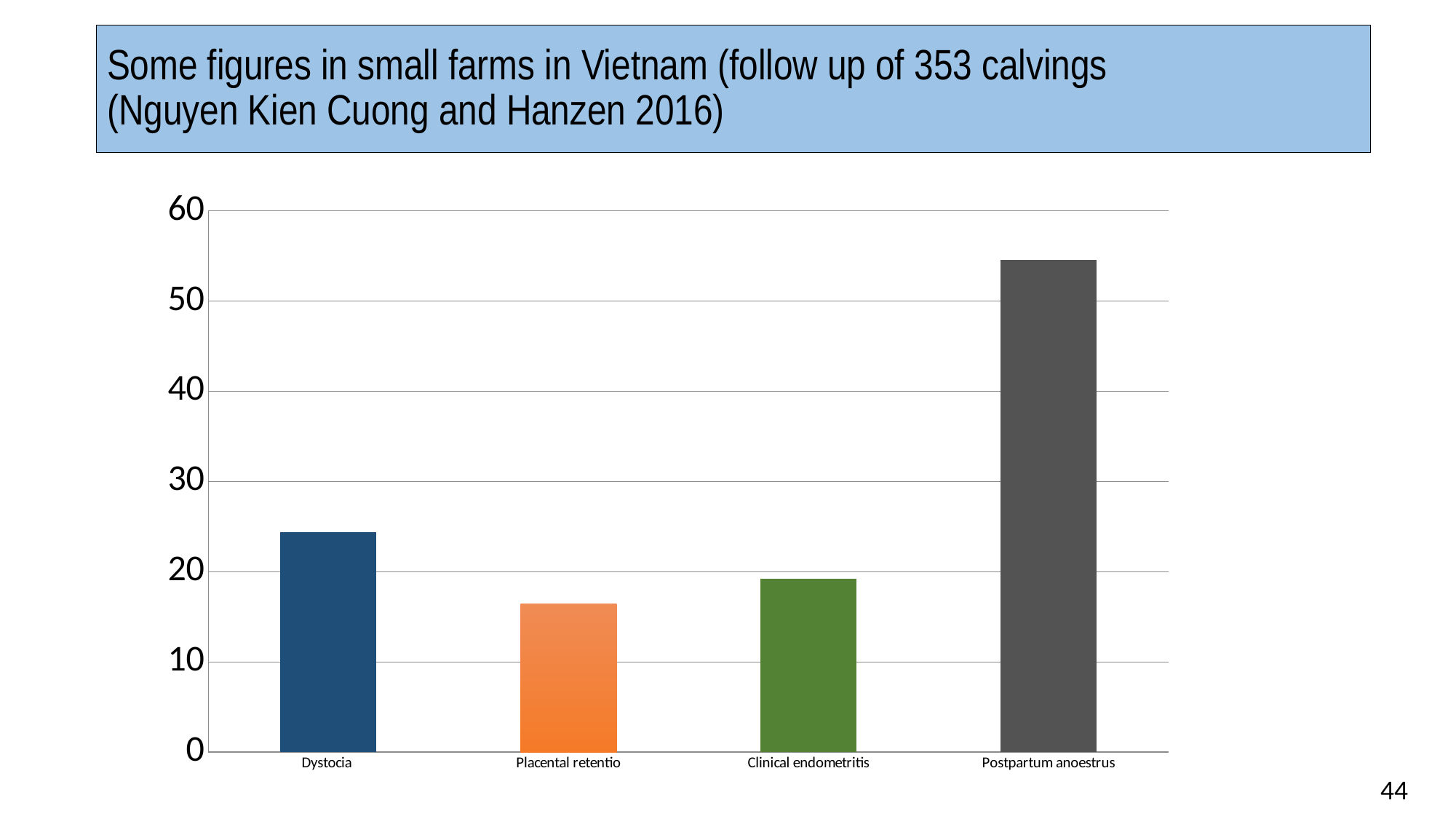
Which category has the lowest bar? Placental retentio What kind of chart is shown on the slide? bar chart Is the value for Dystocia greater or less than 20? greater Is the value for Postpartum anoestrus greater or less than 50? greater How many categories are plotted in the chart? 4 What is the highest value shown on the vertical axis? 60 Is the value for Placental retentio greater or less than 20? less What colour is the bar for Placental retentio? orange Which is larger, the value for Placental retentio or the value for Postpartum anoestrus? Postpartum anoestrus Which is larger, the value for Dystocia or the value for Clinical endometritis? Dystocia Which category has the highest bar? Postpartum anoestrus